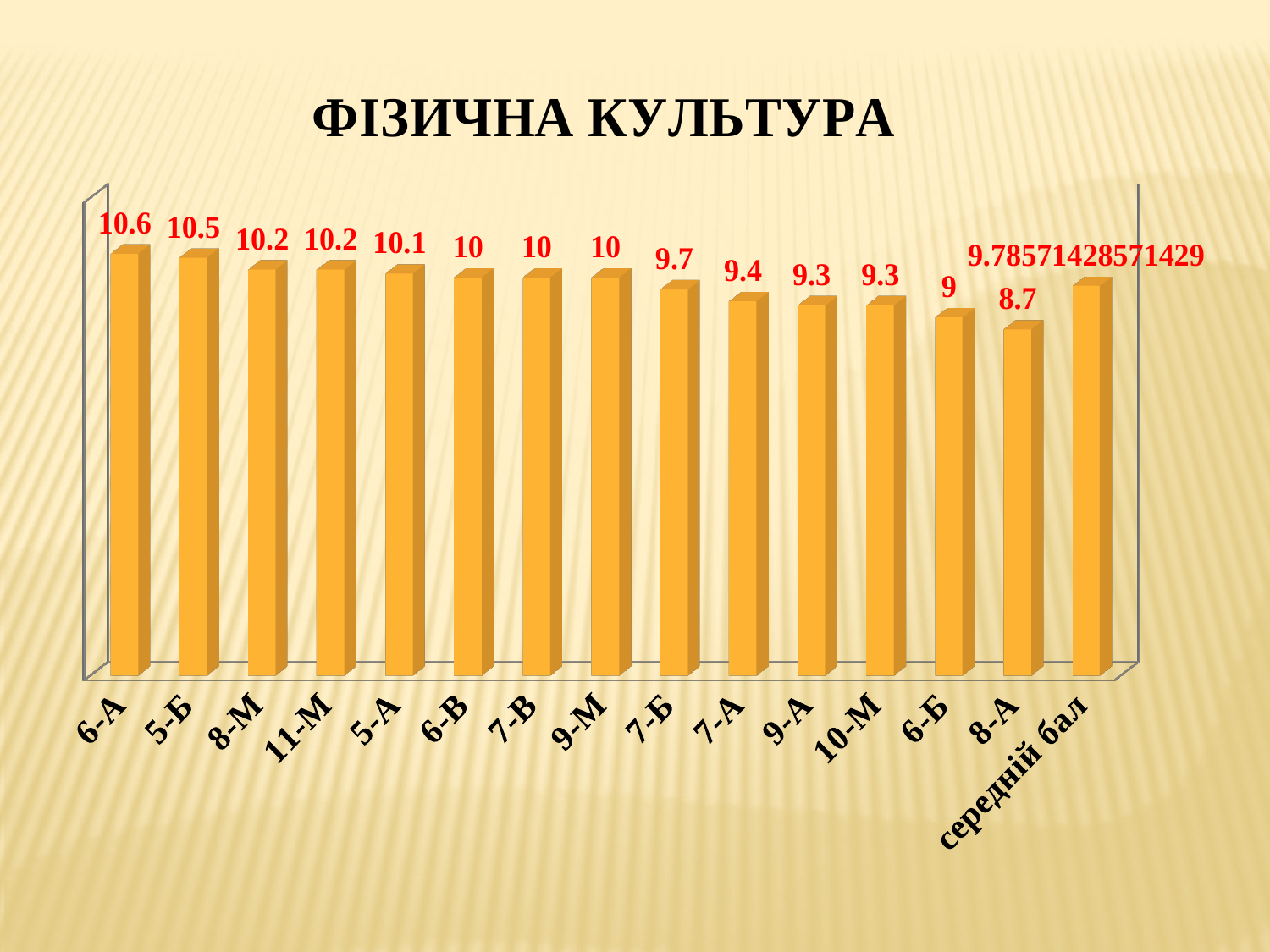
Which class has the lowest value? 8-А Which has a larger value, 5-А or 7-А? 5-А What is the difference between the values for 5-Б and 6-Б? 1.5 What is the difference between the values for 6-А and 8-А? 1.9 What type of chart is shown? bar chart What is the value for 8-А? 8.7 What is the value shown for середній бал? 9.78571428571429 Which class has the highest value? 6-А What is the title of the chart? ФІЗИЧНА КУЛЬТУРА What is the value for 6-А? 10.6 How many bars are shown in the chart? 15 What is the value for 7-Б? 9.7